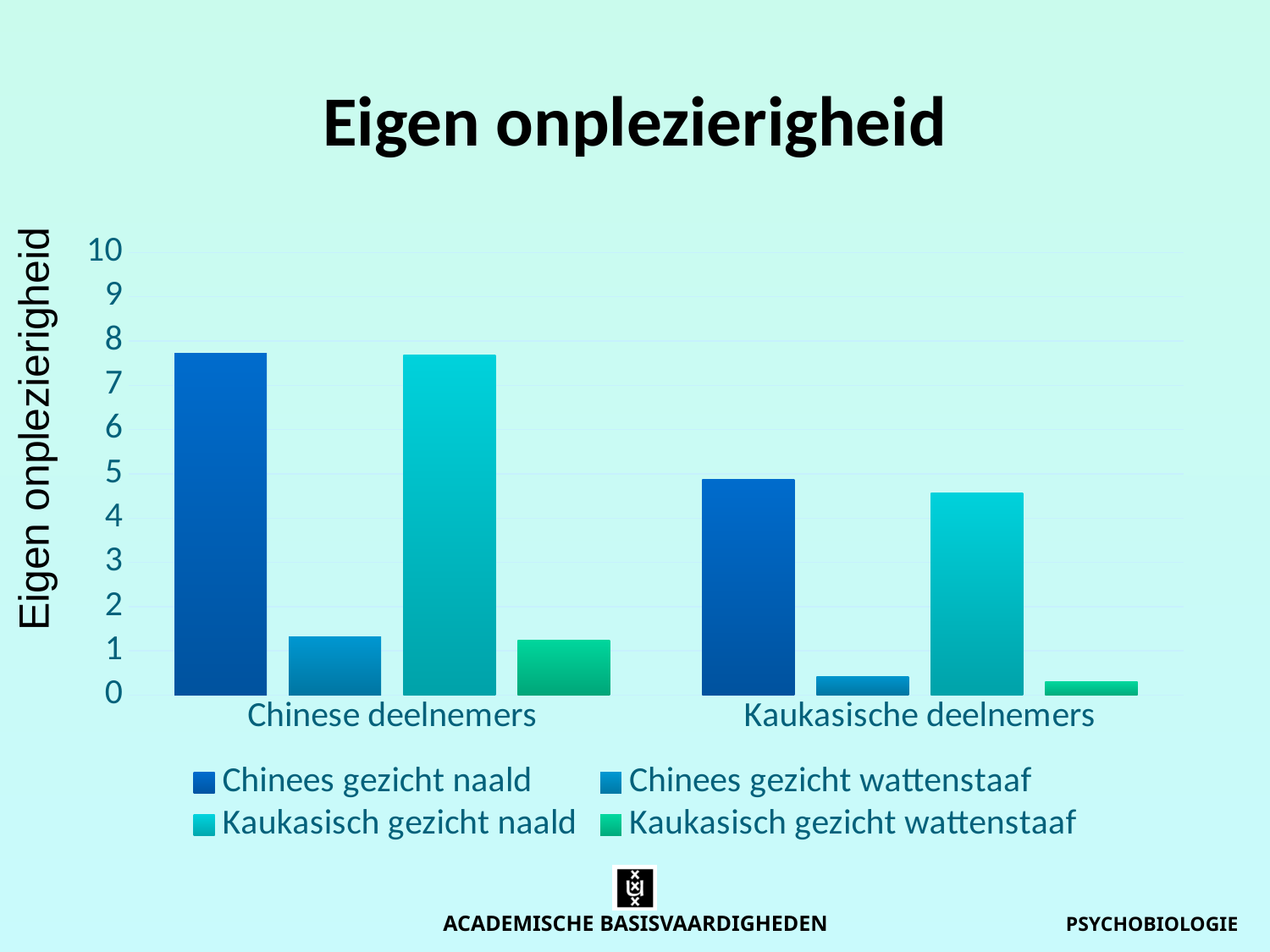
How many participant groups are shown on the x axis? 2 Is the value for Chinees gezicht wattenstaaf among Chinese deelnemers greater or less than 2? less Is the value for Chinees gezicht naald among Chinese deelnemers greater or less than 7? greater Is the value for Kaukasisch gezicht naald among Kaukasische deelnemers greater or less than 5? less Which group has the higher value for Chinees gezicht wattenstaaf, Chinese deelnemers or Kaukasische deelnemers? Chinese deelnemers How many series does the legend list? 4 Among Chinese deelnemers, which is larger: Chinees gezicht naald or Chinees gezicht wattenstaaf? Chinees gezicht naald What kind of chart is shown on the slide? bar chart What is the title of the chart? Eigen onplezierigheid Which group has the higher value for Chinees gezicht naald, Chinese deelnemers or Kaukasische deelnemers? Chinese deelnemers